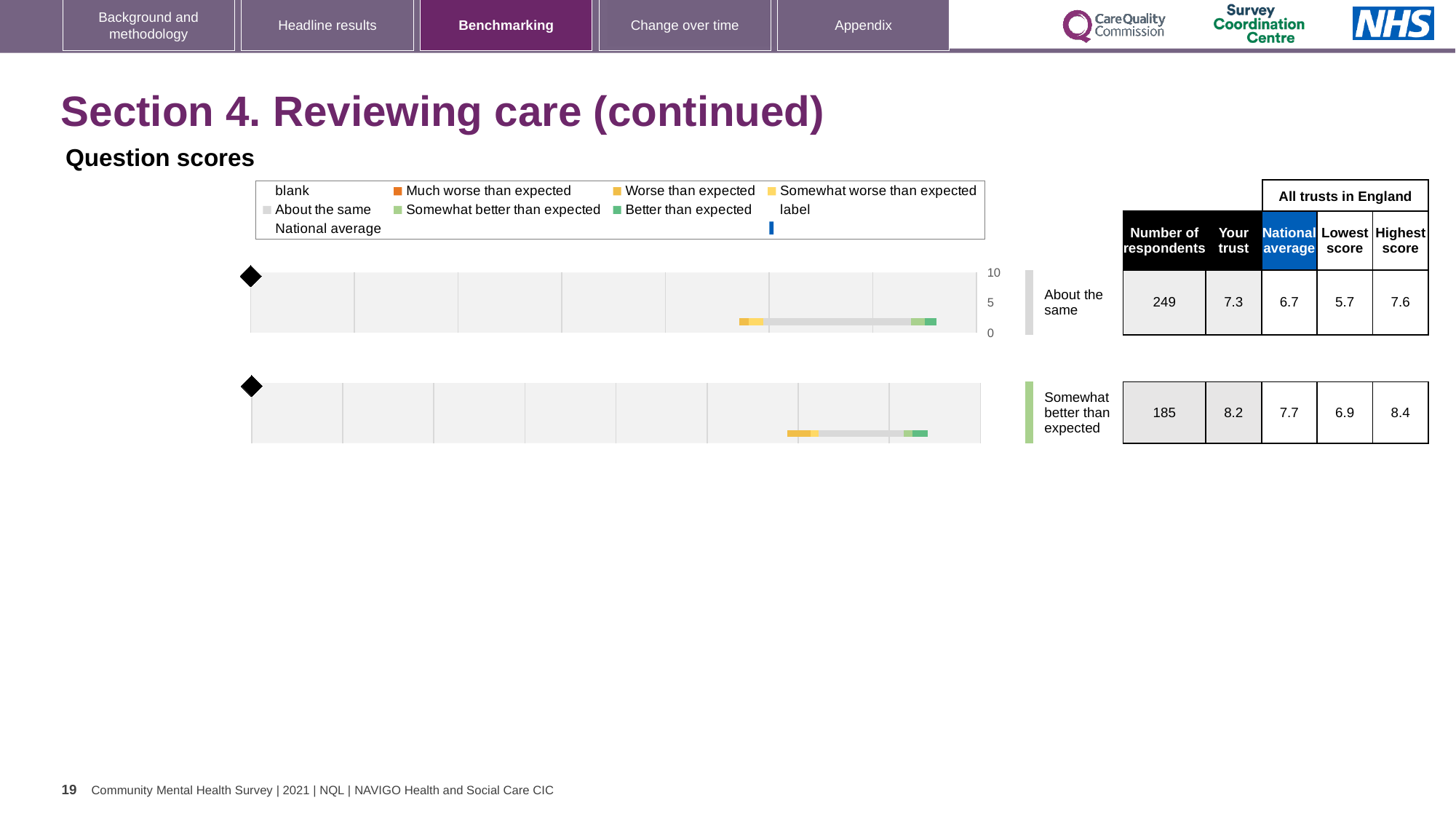
For the bottom chart, which is larger: the 'Your trust' score or the national average? Your trust How many benchmarking charts are shown on the slide? 2 What benchmarking category is assigned to the top chart? About the same What kind of chart is used for the benchmarking displays on this slide? bar chart For the top chart, what is the national average score in the accompanying table? 6.7 For the top chart, what is the 'Your trust' score in the accompanying table? 7.3 In the legend, what colour represents 'Better than expected'? green For the top chart, what is the difference between the 'Your trust' score and the national average? 0.6 For the bottom chart, what is the 'Your trust' score in the accompanying table? 8.2 For the bottom chart, what is the highest score among all trusts in England? 8.4 For the bottom chart, what is the number of respondents shown in the accompanying table? 185 What is the highest value shown on the vertical axis of the top chart? 10